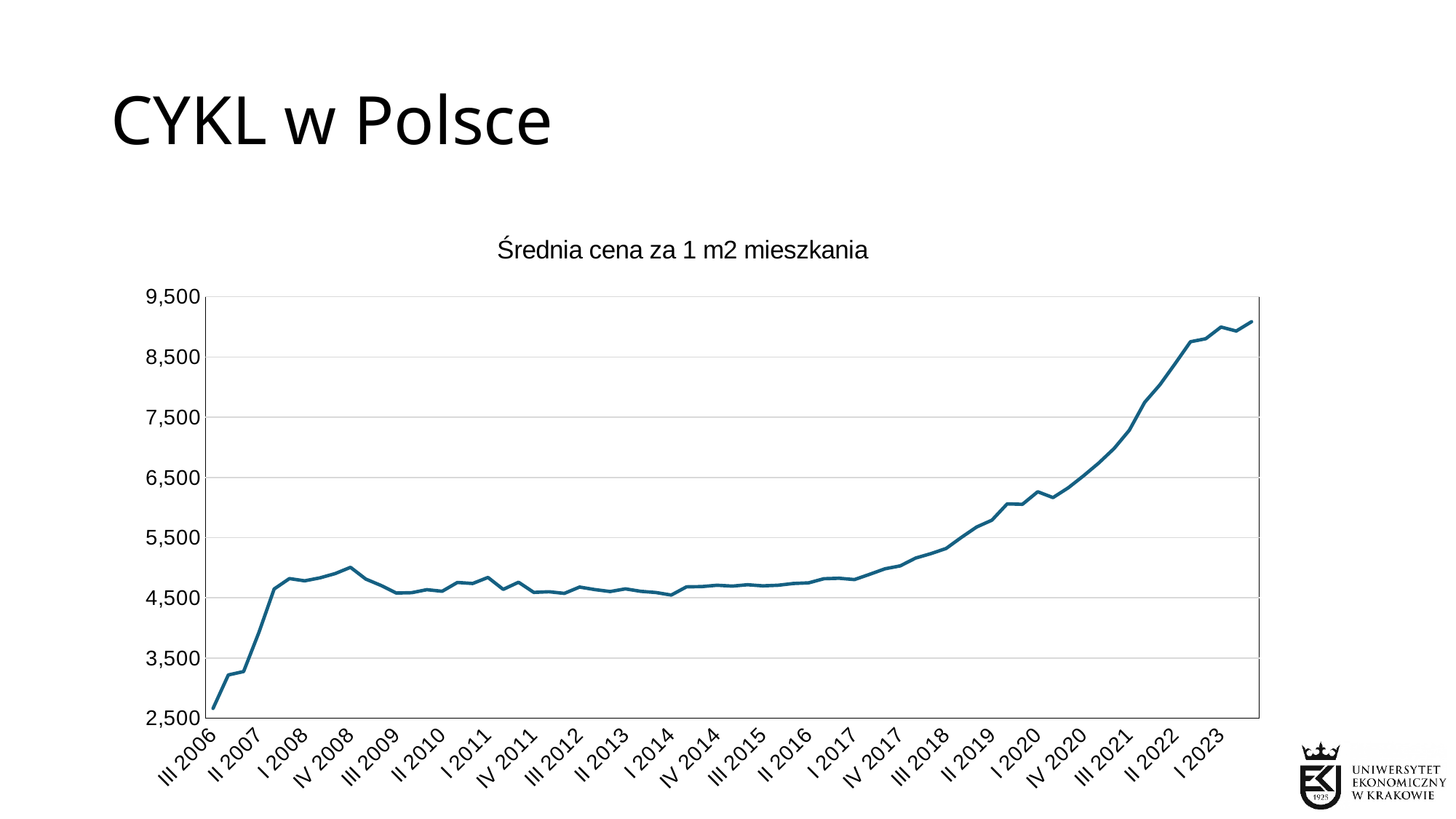
Is the value for III 2021 greater or less than 6,500? greater Is the value for IV 2008 greater or less than 5,500? less Is the value for II 2022 greater or less than 7,500? greater What is the title of the chart? Średnia cena za 1 m2 mieszkania Overall, do the values rise or fall from III 2006 to I 2023? rise Which is larger, the value for I 2023 or the value for I 2008? I 2023 Which labelled quarter has the lowest value on the chart? III 2006 What kind of chart is shown on the slide? line chart Which is larger, the value for IV 2008 or the value for I 2014? IV 2008